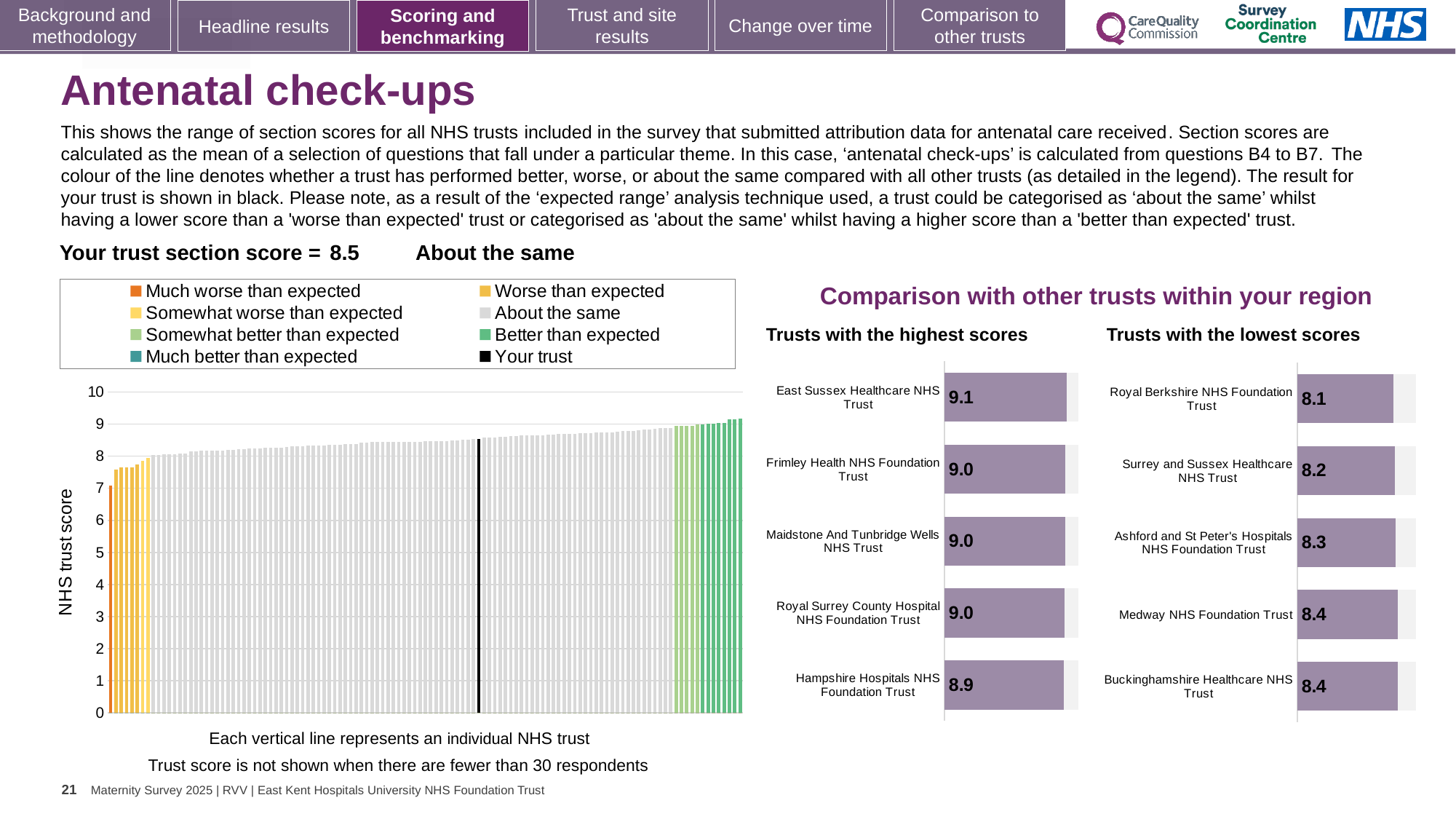
In the main NHS trust score chart on the left, is the value of the leftmost (orange) bar greater or less than 8? less In the 'Trusts with the highest scores' chart, what is the score for East Sussex Healthcare NHS Trust? 9.1 In the 'Trusts with the highest scores' chart, which trust has the highest score? East Sussex Healthcare NHS Trust In the 'Trusts with the highest scores' chart, what is the difference between the scores of East Sussex Healthcare NHS Trust and Hampshire Hospitals NHS Foundation Trust? 0.2 In the 'Trusts with the lowest scores' chart, what is the score for Surrey and Sussex Healthcare NHS Trust? 8.2 What kind of chart is the main chart showing NHS trust scores on the left of the slide? Bar chart How many trusts are shown in the 'Trusts with the highest scores' chart? 5 In the 'Trusts with the lowest scores' chart, which has the higher score: Ashford and St Peter's Hospitals NHS Foundation Trust or Medway NHS Foundation Trust? Medway NHS Foundation Trust How many entries does the legend of the main NHS trust score chart list? 8 In the 'Trusts with the lowest scores' chart, what is the score for Royal Berkshire NHS Foundation Trust? 8.1 In the 'Trusts with the lowest scores' chart, which trust has the lowest score? Royal Berkshire NHS Foundation Trust In the main NHS trust score chart on the left, do the values rise or fall from left to right? Rise